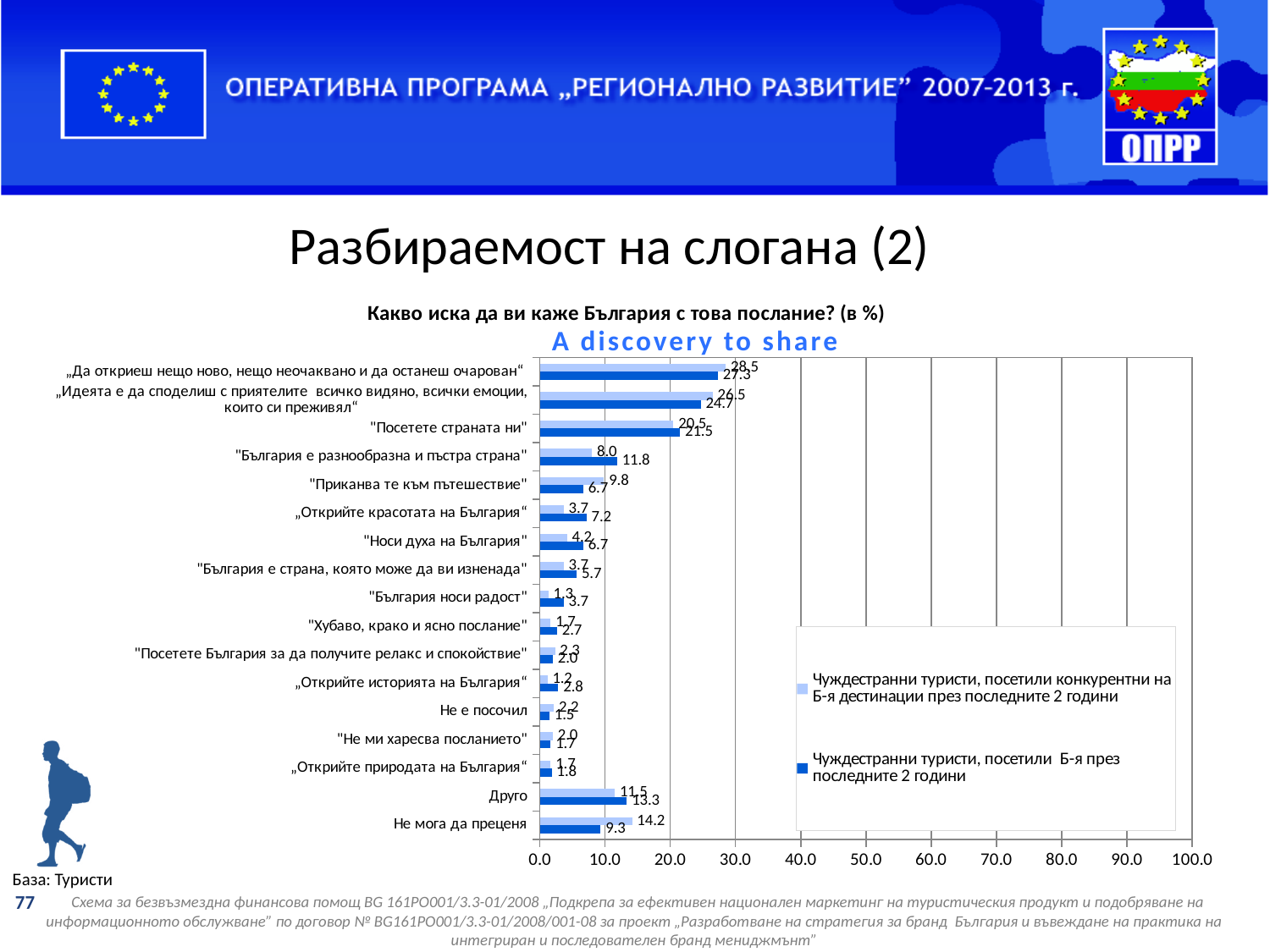
Is the value for „Да откриеш нещо ново, нещо неочаквано и да останеш очарован" among tourists who visited competing destinations greater or less than 20.0? greater What is the value for "Посетете страната ни" among foreign tourists who visited Bulgaria in the last 2 years (Чуждестранни туристи, посетили Б-я през последните 2 години)? 21.5 How many categories (response options) are plotted on the chart? 17 How many series does the legend list? 2 For "Друго", which series has the larger value: tourists who visited Bulgaria or tourists who visited competing destinations? Tourists who visited Bulgaria (13.3) What is the value for "Не мога да преценя" among foreign tourists who visited competing destinations (Чуждестранни туристи, посетили конкурентни на Б-я дестинации през последните 2 години)? 14.2 What is the difference between the two series for "Не мога да преценя" (14.2 vs 9.3)? 4.9 What is the difference between the two series for "Приканва те към пътешествие" (9.8 vs 6.7)? 3.1 What is the value for "България е разнообразна и пъстра страна" among foreign tourists who visited Bulgaria in the last 2 years? 11.8 What is the slogan shown as the chart subtitle? A discovery to share What type of chart is shown on the slide? Bar chart Which category has the highest value for foreign tourists who visited competing destinations? „Да откриеш нещо ново, нещо неочаквано и да останеш очарован"